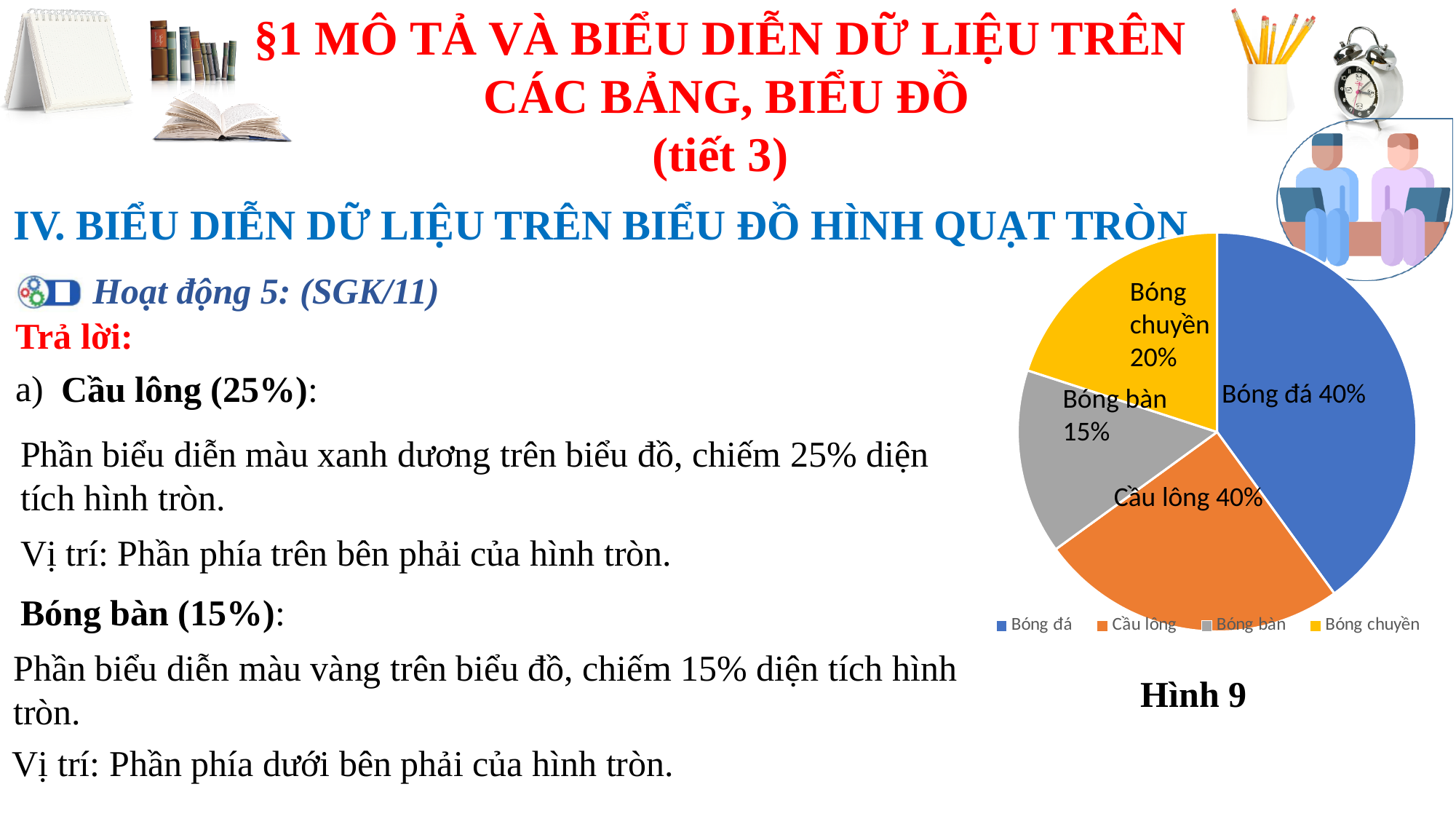
What percentage is shown for Bóng bàn in the pie chart? 15% What kind of chart is shown on the slide? Pie chart What is the difference between the percentages shown for Bóng đá and Bóng bàn? 25% What percentage is shown for Bóng chuyền in the pie chart? 20% What colour is the Bóng đá slice in the pie chart? Blue What percentage is shown for Bóng đá in the pie chart? 40% Which is larger in the pie chart, Bóng chuyền or Bóng bàn? Bóng chuyền Which category has the smallest slice in the pie chart? Bóng bàn What percentage label is printed on the Cầu lông slice of the pie chart? 40% How many slices does the pie chart have? 4 What is the difference between the percentages shown for Bóng chuyền and Bóng bàn? 5% How many entries does the legend of the pie chart list? 4